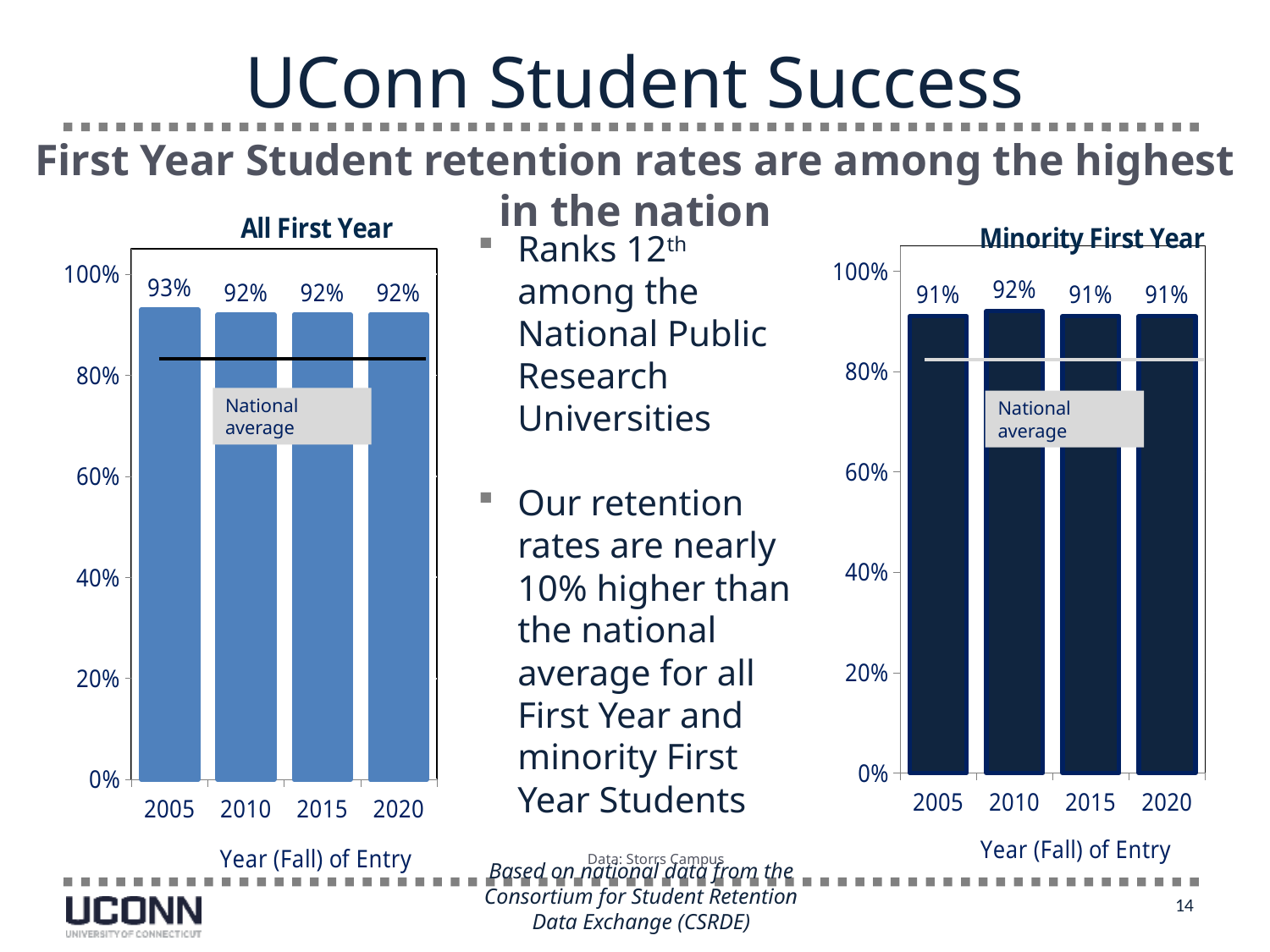
In the All First Year chart, which entry year has the highest retention rate? 2005 In the All First Year chart, what is the difference between the 2005 and 2010 retention rates? 1% In the All First Year chart, what is the retention rate for the 2005 entry year? 93% In the All First Year chart, is the national average line greater or less than 80%? greater In the Minority First Year chart, which entry year has the highest retention rate? 2010 How many entry years are shown in the Minority First Year chart? 4 What is the x-axis label of the Minority First Year chart? Year (Fall) of Entry Which is larger: the 2005 retention rate in the All First Year chart or the 2005 retention rate in the Minority First Year chart? All First Year (93%) What type of chart is the All First Year chart? Bar chart In the Minority First Year chart, what is the retention rate for the 2020 entry year? 91% In the All First Year chart, what is the retention rate for the 2020 entry year? 92% In the Minority First Year chart, what is the retention rate for the 2010 entry year? 92%